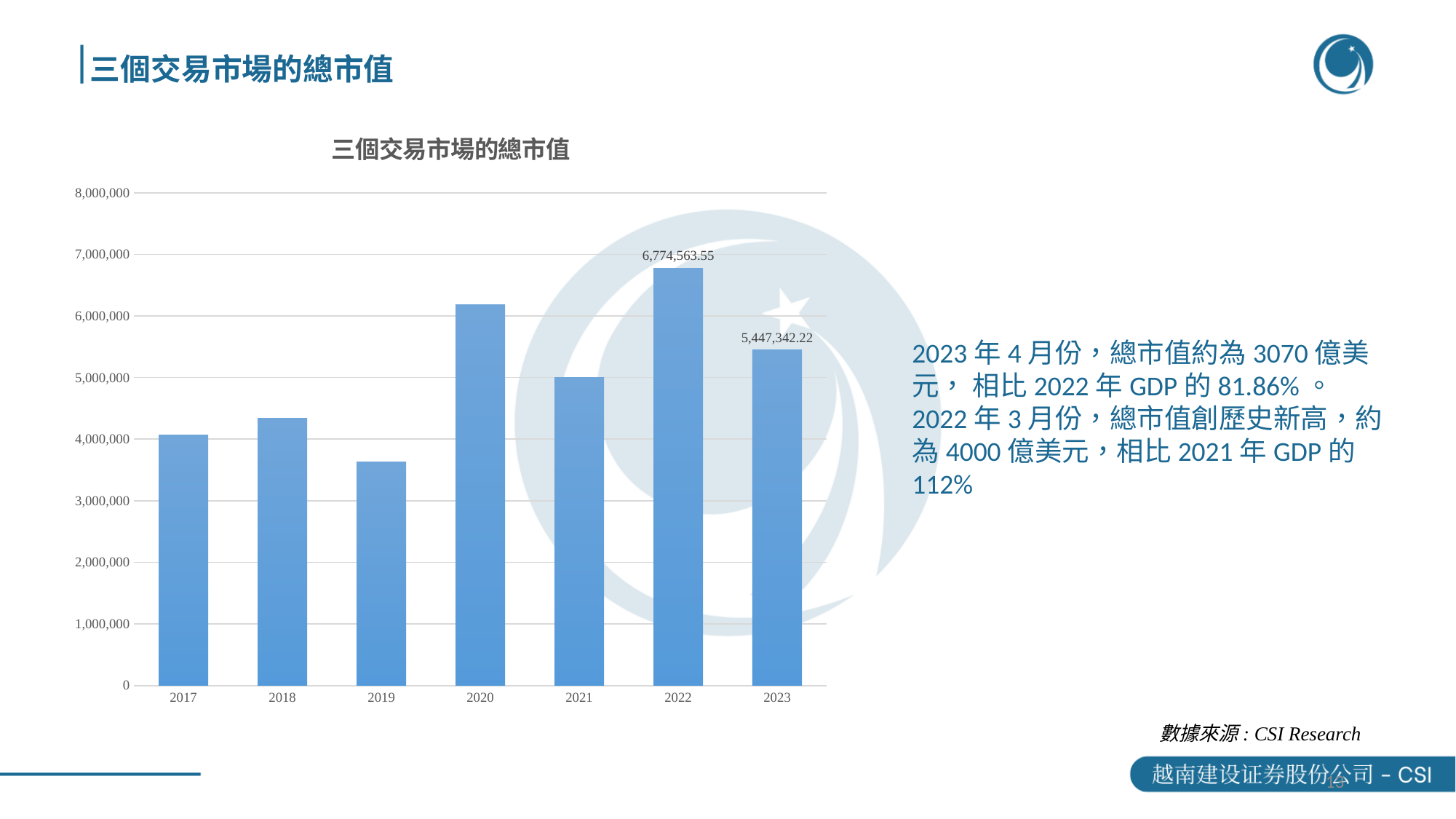
What kind of chart is shown on the slide? bar chart Does the value rise or fall from 2022 to 2023? fall What is the difference between the values for 2022 and 2023? 1,327,221.33 How many years are shown on the x axis of the chart? 7 Which year has the larger value, 2017 or 2018? 2018 What is the value for 2023 in the chart? 5,447,342.22 Which year has the larger value, 2020 or 2021? 2020 What is the value for 2022 in the chart? 6,774,563.55 Which year has the highest value in the chart? 2022 Which year has the lowest value in the chart? 2019 Is the value for 2020 greater or less than 6,000,000? greater Is the value for 2019 greater or less than 4,000,000? less